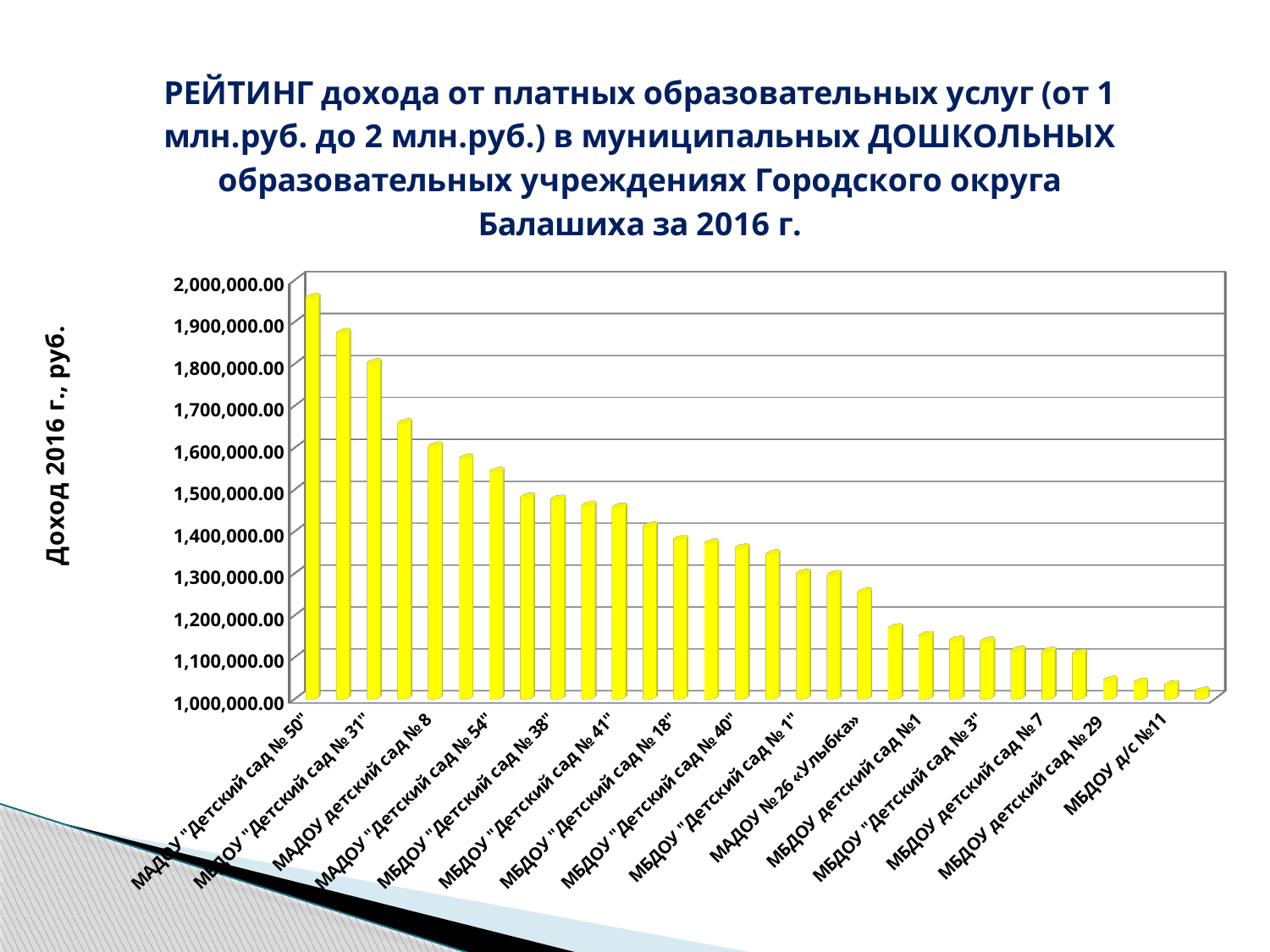
What kind of chart is shown on the slide? Bar chart Is the value for МБДОУ д/с №11 greater or less than 1,100,000.00? less Which institution has the highest income in the chart? МАДОУ "Детский сад № 50" Is the value for МБДОУ детский сад № 7 greater or less than 1,200,000.00? less Is the value for МАДОУ № 26 «Улыбка» greater or less than 1,300,000.00? less Which has the larger value: МАДОУ детский сад № 8 or МАДОУ № 26 «Улыбка»? МАДОУ детский сад № 8 What is the title of the vertical axis? Доход 2016 г., руб. Do the values rise or fall moving from left to right along the x axis? Fall